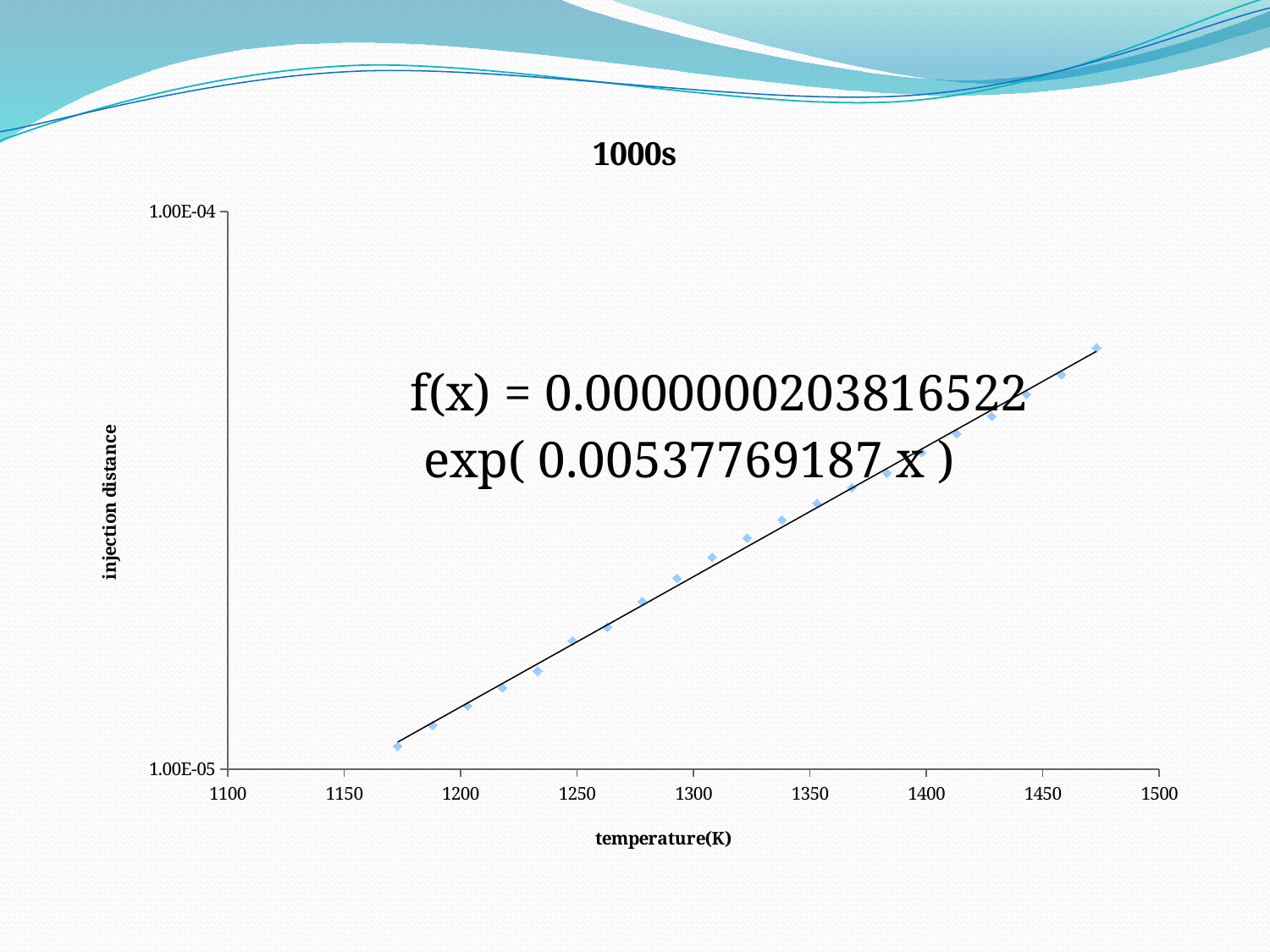
How many data points are plotted on the chart? 21 What kind of chart is shown on the slide? Scatter chart with a trendline Which has the larger injection distance: the point near 1473 K or the point near 1173 K? The point near 1473 K Is the injection distance at the lowest plotted temperature (about 1173 K) greater or less than 1.00E-04? less Does injection distance rise or fall as temperature increases along the x axis? Rise Does the lowest injection distance occur at the lowest or the highest plotted temperature? The lowest temperature What is the title of the chart? 1000s Which has the larger injection distance: the point near 1300 K or the point near 1400 K? The point near 1400 K Is the injection distance at the highest plotted temperature (about 1473 K) greater or less than 1.00E-05? greater What trendline equation is displayed on the chart? f(x) = 0.0000000203816522 exp( 0.00537769187 x ) Does the highest injection distance occur at the lowest or the highest plotted temperature? The highest temperature Is the injection distance at the highest plotted temperature greater or less than 1.00E-04? less